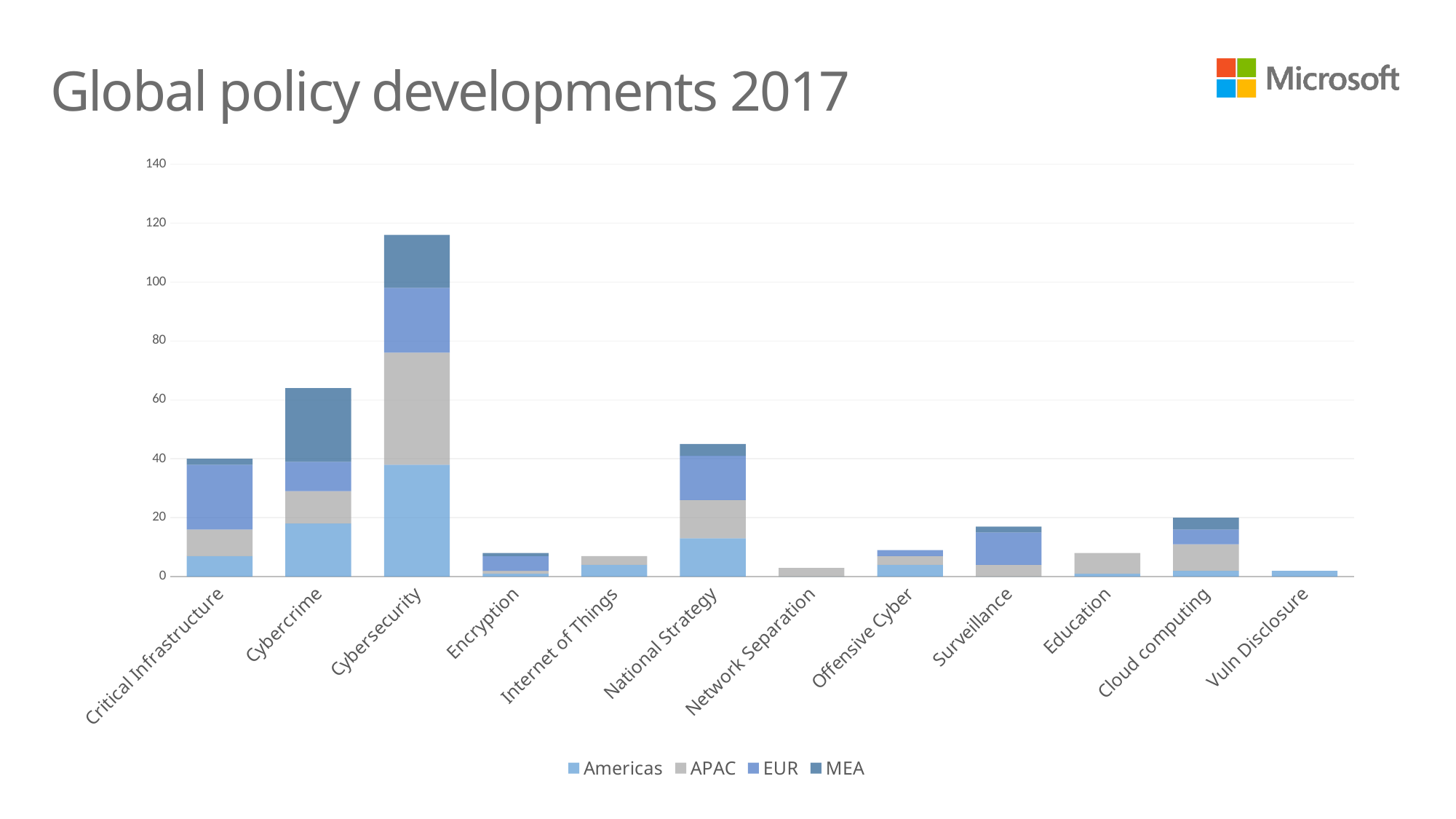
What kind of chart is shown on the slide? Stacked bar chart Which series are listed in the legend? Americas, APAC, EUR, MEA What is the title of the slide? Global policy developments 2017 Which category has the tallest stacked bar? Cybersecurity Which is larger, the total bar for Cybercrime or for National Strategy? Cybercrime Is the total value for Encryption greater or less than 20? less Is the total value for National Strategy greater or less than 60? less Is the total value for Cybercrime greater or less than 60? greater How many categories are shown on the x axis? 12 How many series does the legend list? 4